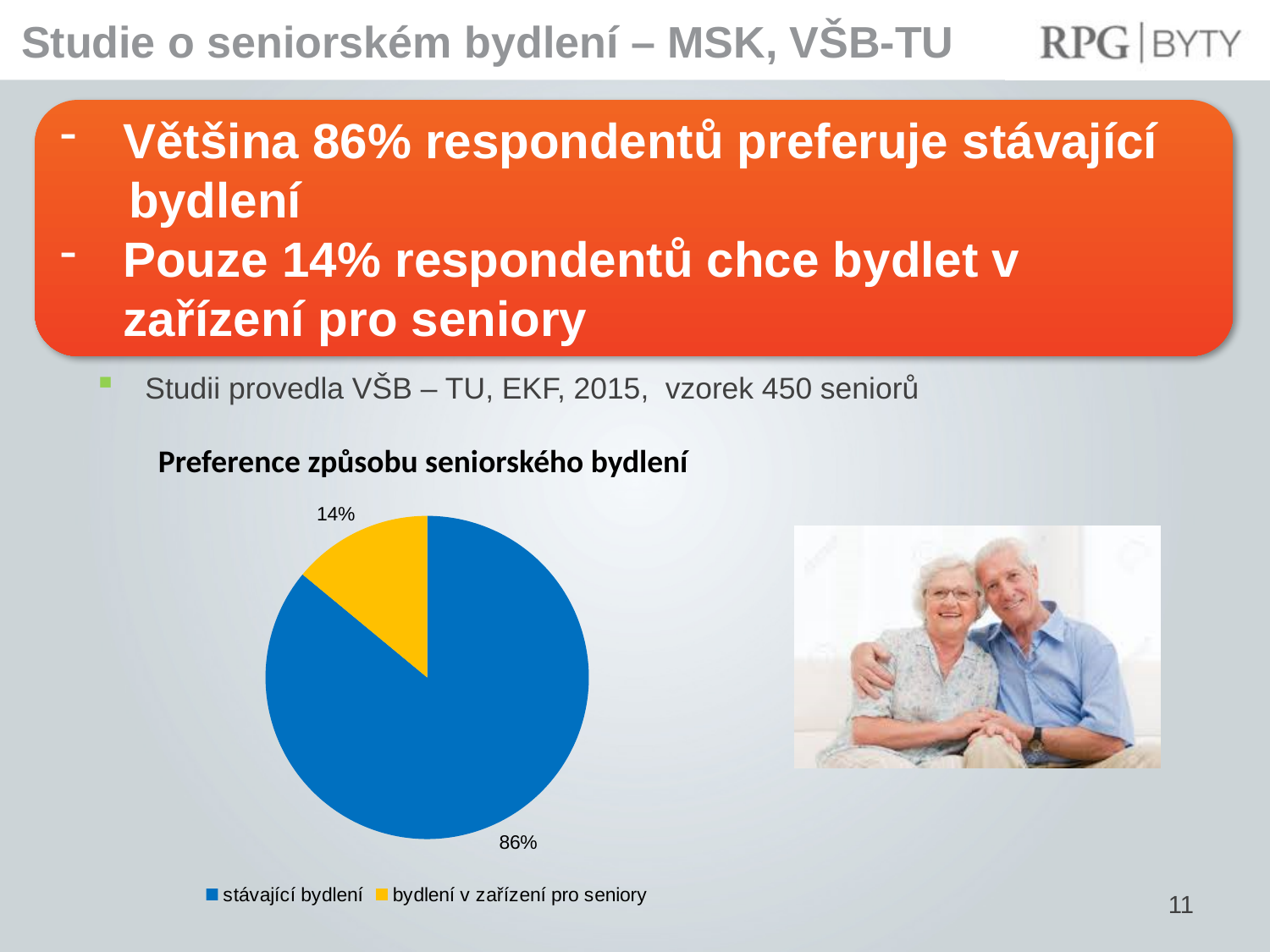
What share of the pie does 'bydlení v zařízení pro seniory' represent? 14% What share of the pie does 'stávající bydlení' represent? 86% How many slices does the pie chart have? 2 What is the difference in percentage points between 'stávající bydlení' and 'bydlení v zařízení pro seniory'? 72 percentage points Which is larger: the slice for 'stávající bydlení' or the slice for 'bydlení v zařízení pro seniory'? stávající bydlení Which category has the smallest slice of the pie? bydlení v zařízení pro seniory How many entries does the legend list? 2 What type of chart is shown on the slide? pie chart What is the title of the chart? Preference způsobu seniorského bydlení Which category has the largest slice of the pie? stávající bydlení What colour is the slice for 'bydlení v zařízení pro seniory'? yellow